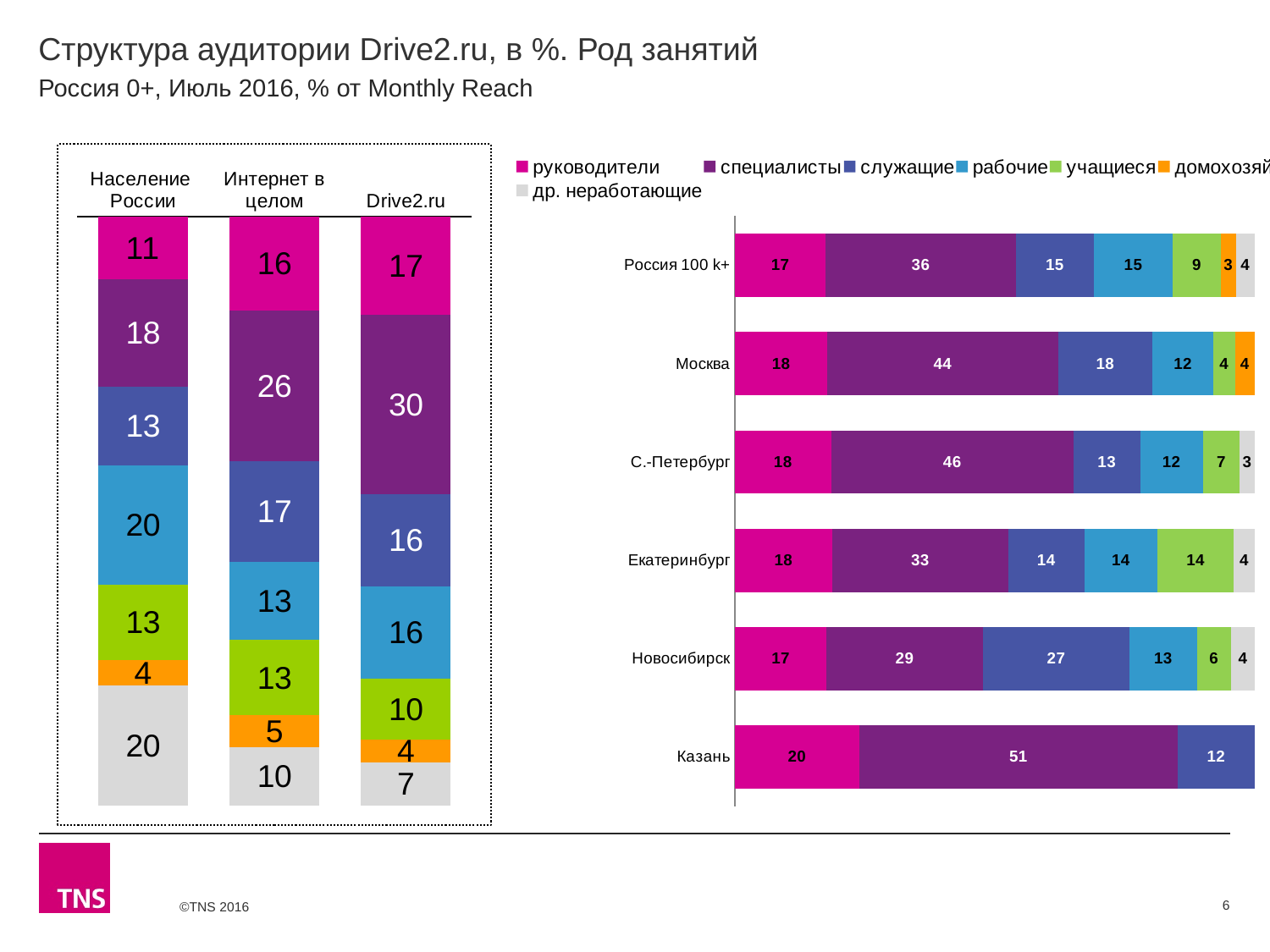
In the right chart, what is the value for специалисты in Казань? 51 In the left chart, what is the difference between the специалисты values for Drive2.ru and Население России? 12 In the right chart, which is larger: the рабочие value for Россия 100 k+ or for Москва? Россия 100 k+ In the left chart, what is the value for др. неработающие in the Население России column? 20 In the right chart, which city has the highest value for специалисты? Казань How many series does the legend of the right chart list? 7 What type of chart is the right chart? Stacked bar chart How many cities or regions are shown on the right chart? 6 In the right chart, which city has the lowest value for специалисты? Новосибирск In the left chart, what is the value for учащиеся in the Интернет в целом column? 13 In the left chart, what is the value for специалисты in the Drive2.ru column? 30 In the right chart, what is the value for служащие in Новосибирск? 27